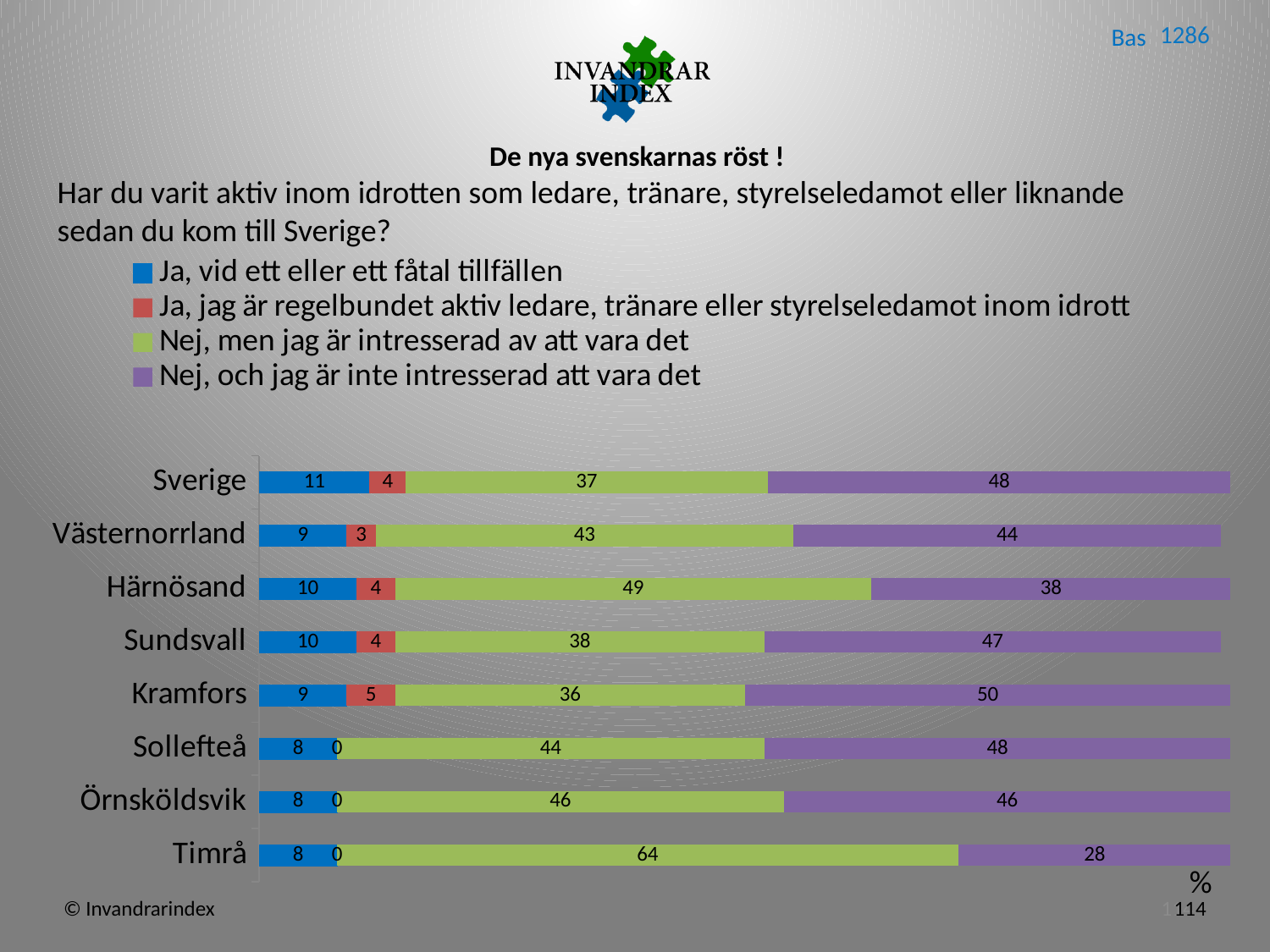
Which category has the highest value in the series "Nej, och jag är inte intresserad att vara det"? Kramfors How many categories are shown on the chart? 8 Which is larger: the value for Sundsvall or for Härnösand in the series "Nej, och jag är inte intresserad att vara det"? Sundsvall What is the value for Sverige in the series "Ja, vid ett eller ett fåtal tillfällen"? 11 What is the difference between Härnösand and Sverige in the series "Nej, men jag är intresserad av att vara det"? 12 What kind of chart is shown on the slide? Stacked bar chart How many series does the legend list? 4 What is the value for Kramfors in the series "Ja, jag är regelbundet aktiv ledare, tränare eller styrelseledamot inom idrott"? 5 Which category has the lowest value in the series "Nej, och jag är inte intresserad att vara det"? Timrå Which category has the highest value in the series "Nej, men jag är intresserad av att vara det"? Timrå What is the value for Timrå in the series "Nej, men jag är intresserad av att vara det"? 64 What is the total of the stacked bar for Sverige? 100